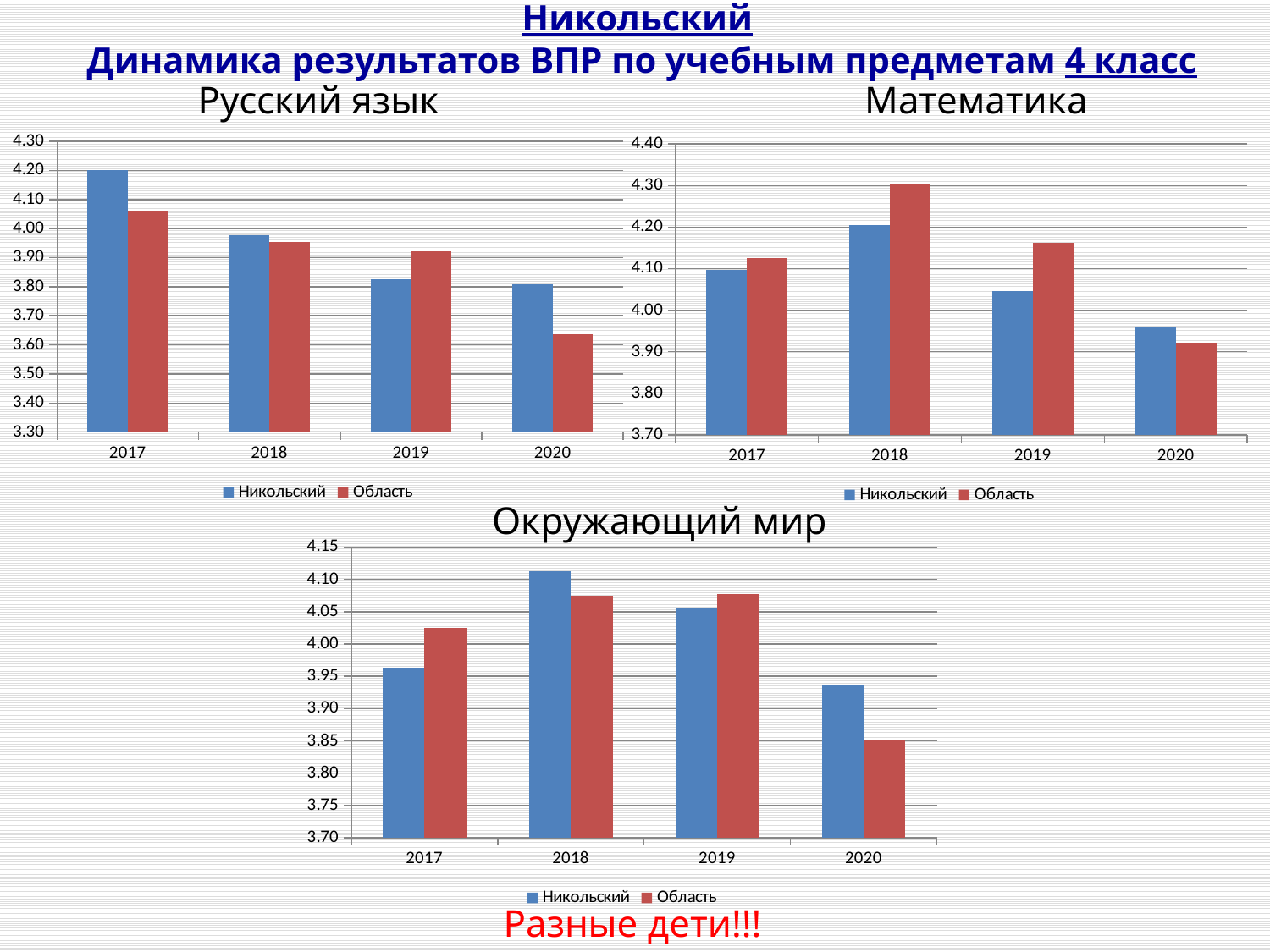
In the Математика chart, which is larger in 2020: Никольский or Область? Никольский How many series does the legend of the Окружающий мир chart list? 2 In the Русский язык chart, is the value for Никольский in 2017 greater or less than 4.10? greater In the Русский язык chart, which is larger in 2019: Никольский or Область? Область How many years are shown on the x axis of the Математика chart? 4 In the Русский язык chart, which year has the highest value for Никольский? 2017 In the Математика chart, which year has the highest value for Область? 2018 In the Русский язык chart, do the Никольский values rise or fall from 2017 to 2020? fall In the Окружающий мир chart, is the value for Никольский in 2018 greater or less than 4.05? greater In the Окружающий мир chart, which year has the lowest value for Область? 2020 In the Русский язык chart, is the value for Область in 2020 greater or less than 3.70? less